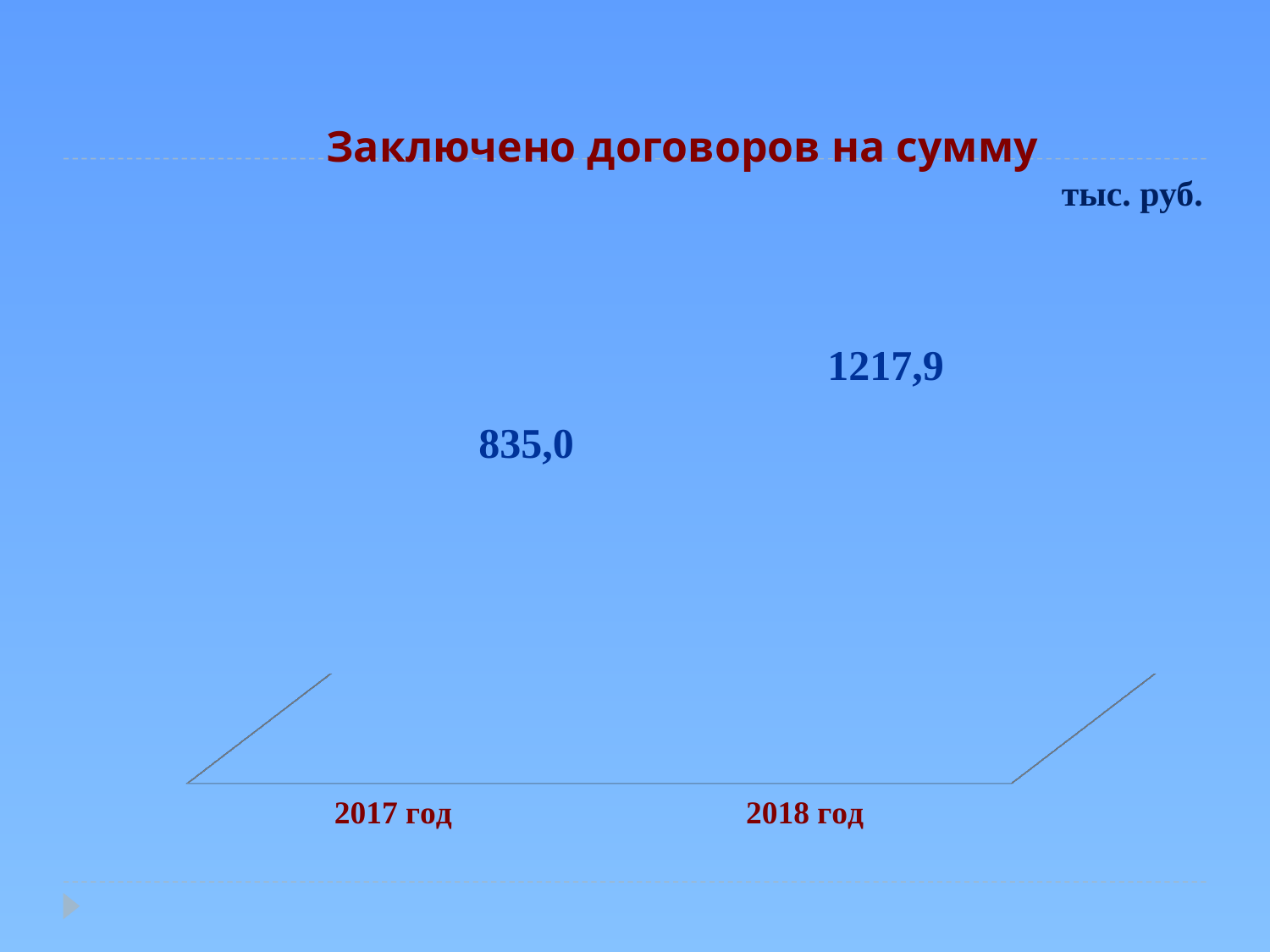
Which year has the highest value? 2018 год What is the title of the chart? Заключено договоров на сумму How many categories are shown on the chart? 2 Which year has the lowest value? 2017 год Do the values rise or fall from 2017 год to 2018 год? rise What is the difference between the values for 2018 год and 2017 год? 382,9 What is the value for 2018 год? 1217,9 Which is larger, the value for 2017 год or for 2018 год? 2018 год In what units are the chart values given? тыс. руб. What is the value for 2017 год? 835,0